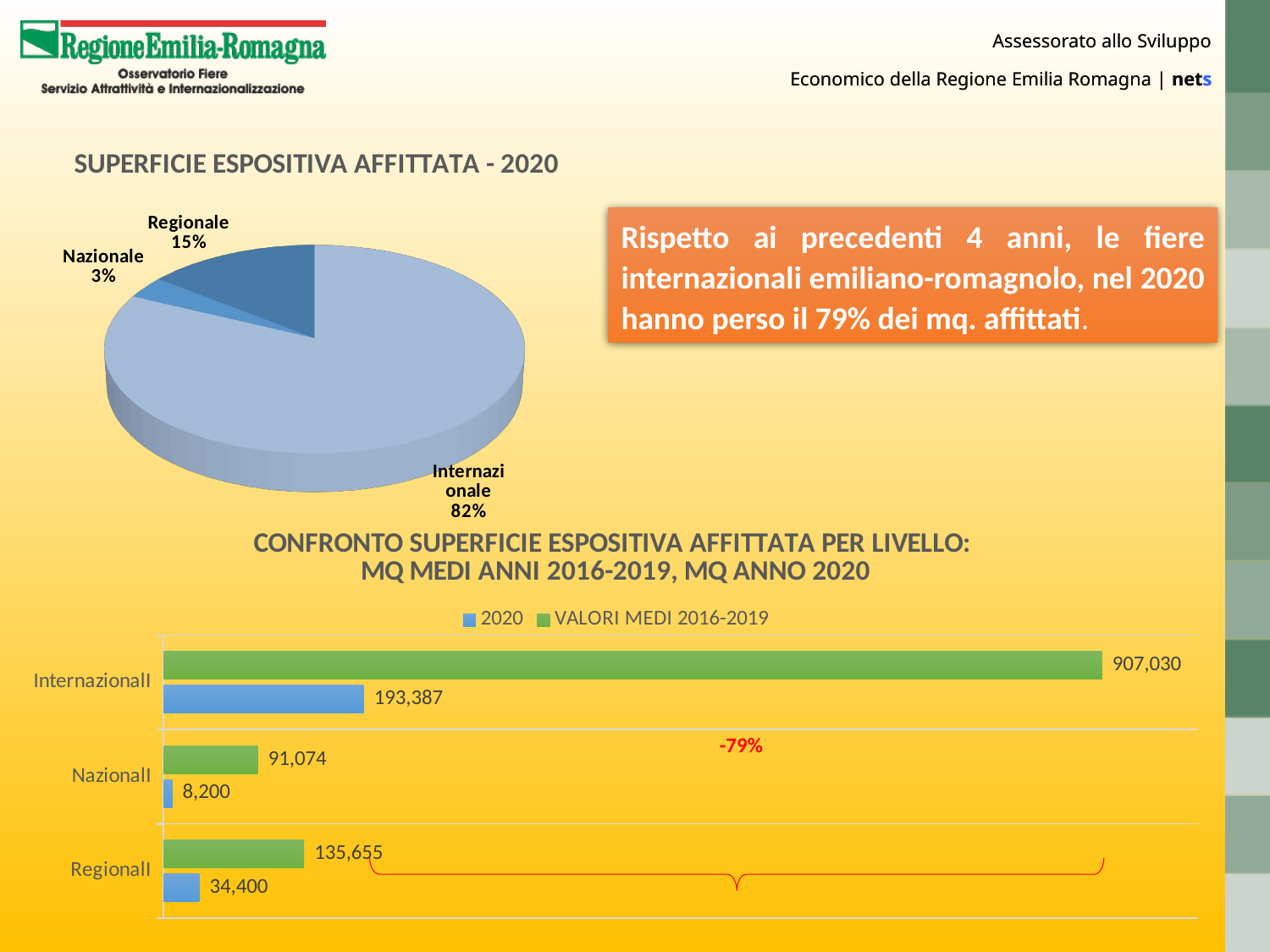
In the pie chart 'SUPERFICIE ESPOSITIVA AFFITTATA - 2020', which slice is the smallest? Nazionale In the bar chart 'CONFRONTO SUPERFICIE ESPOSITIVA AFFITTATA PER LIVELLO', what is the 2020 value for Nazionali? 8,200 In the bar chart 'CONFRONTO SUPERFICIE ESPOSITIVA AFFITTATA PER LIVELLO', is the VALORI MEDI 2016-2019 value for Regionali larger or smaller than the VALORI MEDI 2016-2019 value for Nazionali? Larger How many slices does the pie chart 'SUPERFICIE ESPOSITIVA AFFITTATA - 2020' have? 3 In the bar chart 'CONFRONTO SUPERFICIE ESPOSITIVA AFFITTATA PER LIVELLO', what is the 2020 value for Regionali? 34,400 What kind of chart is the chart at the top left of the slide? Pie chart In the pie chart 'SUPERFICIE ESPOSITIVA AFFITTATA - 2020', what share does Regionale have? 15% In the bar chart 'CONFRONTO SUPERFICIE ESPOSITIVA AFFITTATA PER LIVELLO', what is the difference between the VALORI MEDI 2016-2019 value and the 2020 value for Internazionali? 713,643 In the bar chart 'CONFRONTO SUPERFICIE ESPOSITIVA AFFITTATA PER LIVELLO', which category has the highest 2020 value? Internazionali In the pie chart 'SUPERFICIE ESPOSITIVA AFFITTATA - 2020', what share does Internazionale have? 82% In the bar chart 'CONFRONTO SUPERFICIE ESPOSITIVA AFFITTATA PER LIVELLO', what is the VALORI MEDI 2016-2019 value for Internazionali? 907,030 How many series does the legend of the bar chart 'CONFRONTO SUPERFICIE ESPOSITIVA AFFITTATA PER LIVELLO' list? 2